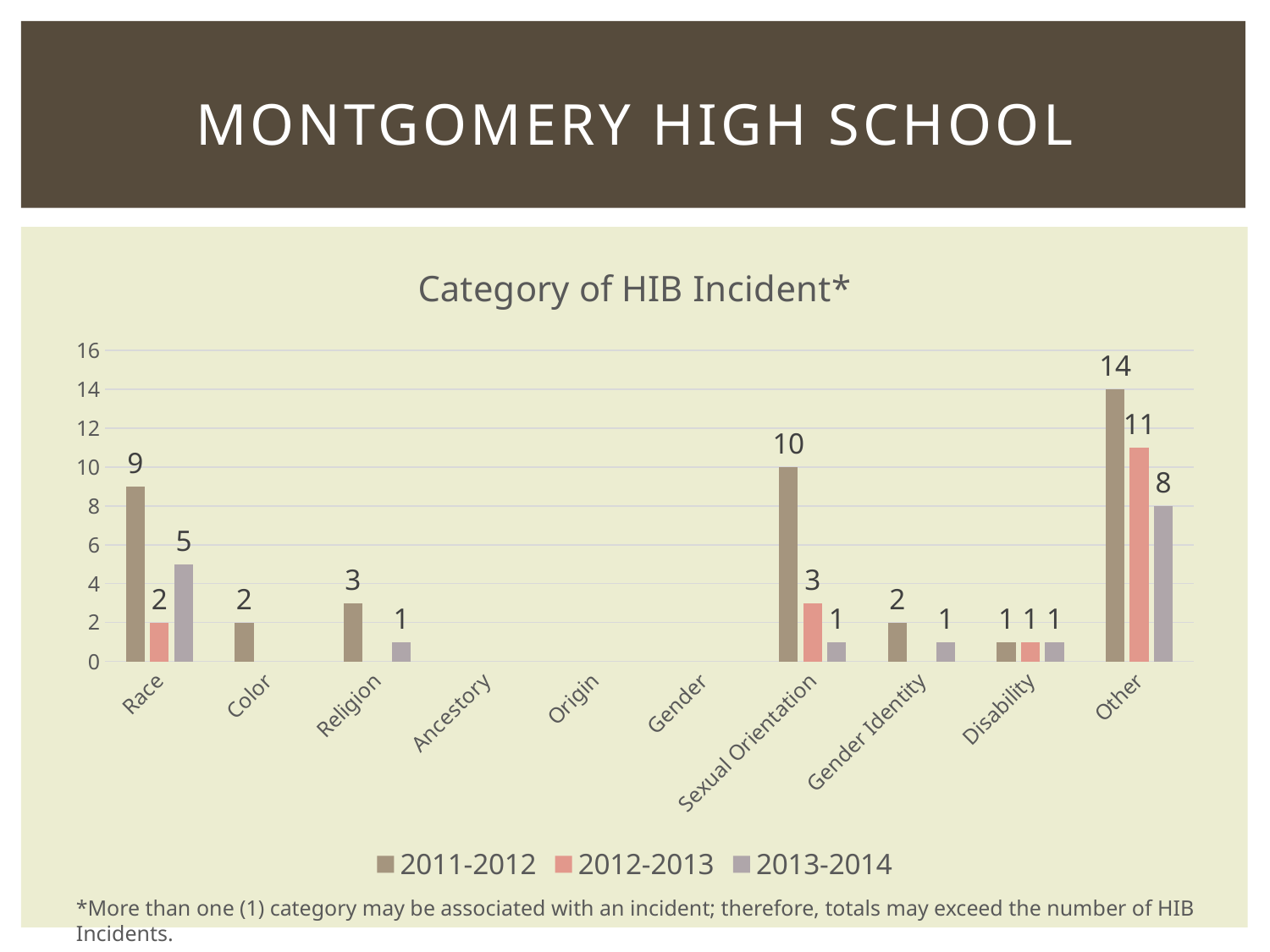
How many categories are shown on the x axis? 10 Which is larger: the 2011-2012 value for Sexual Orientation or the 2011-2012 value for Race? Sexual Orientation What is the value for Race in the 2011-2012 series? 9 What is the total of the three series values for Race? 16 What is the value for Sexual Orientation in the 2013-2014 series? 1 Which category has the highest value in the 2011-2012 series? Other What is the value for Other in the 2012-2013 series? 11 What kind of chart is shown on the slide? Bar chart What is the difference between the 2011-2012 and 2013-2014 values for Other? 6 What is the value for Religion in the 2011-2012 series? 3 What is the title of the chart? Category of HIB Incident* How many series does the legend list? 3